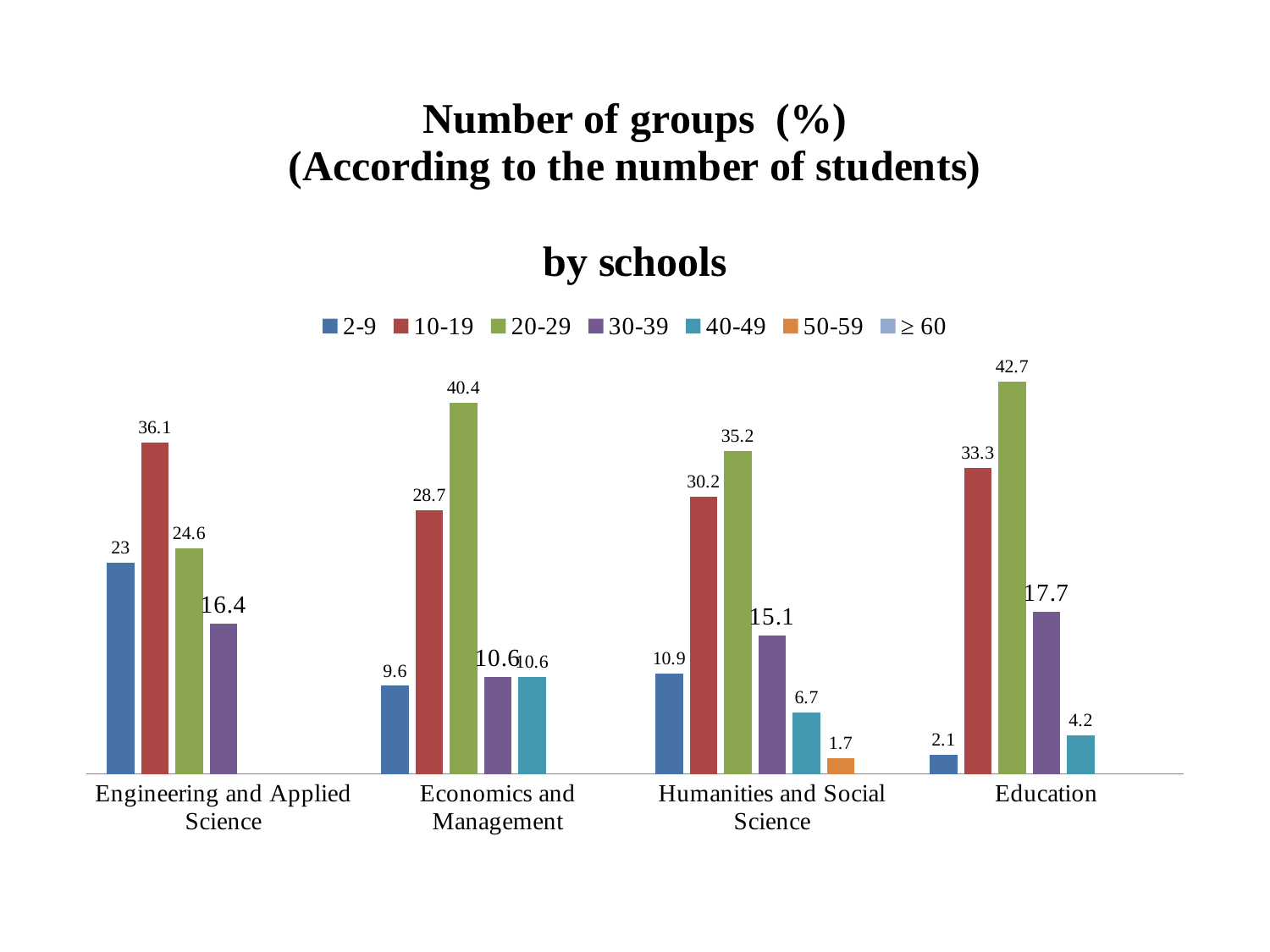
What is the difference between the 20-29 and 10-19 values in Education? 9.4 Which school is the only one with a value shown for the 50-59 series? Humanities and Social Science Which school has the highest value for the 20-29 series? Education What kind of chart is shown on the slide? bar chart How many series does the legend list? 7 How many schools are shown on the x axis? 4 What is the value for the 2-9 series in Education? 2.1 What is the value for the 40-49 series in Humanities and Social Science? 6.7 Which school has the lowest value for the 2-9 series? Education Which is larger in Engineering and Applied Science: the 2-9 value or the 20-29 value? 20-29 What is the value for the 20-29 series in Economics and Management? 40.4 What is the value for the 10-19 series in Engineering and Applied Science? 36.1